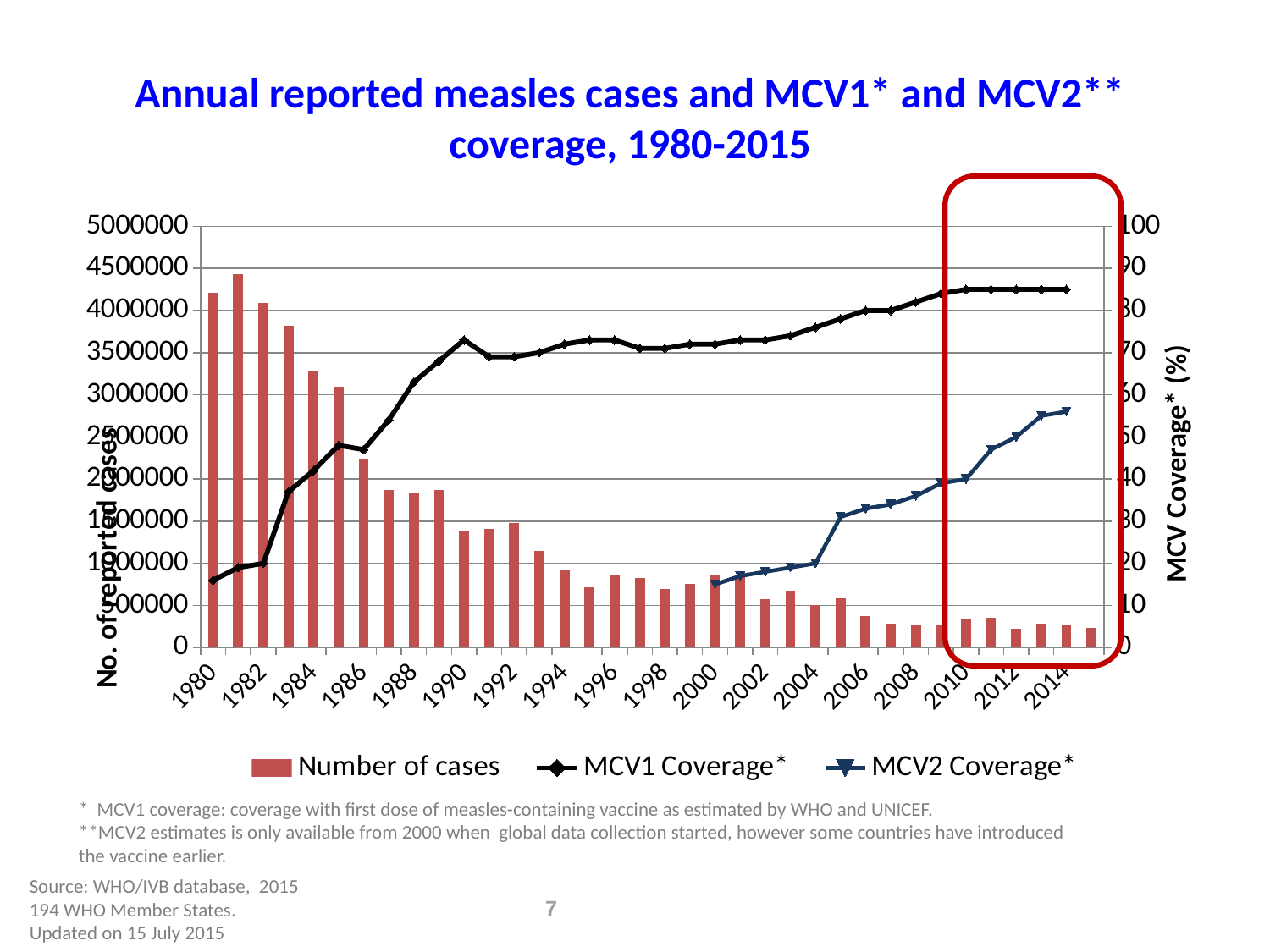
Which year has the highest number of reported measles cases? 1981 In 2010, which is higher, MCV1 coverage or MCV2 coverage? MCV1 coverage Which is larger, the number of reported cases in 1981 or in 1983? 1981 Is the MCV1 coverage in 2014 greater or less than 80? greater Is the number of reported cases in 1981 greater or less than 4000000? greater Is the MCV2 coverage in 2000 greater or less than 20? less What kind of chart is shown on the slide? A combined bar and line chart How many series does the legend list? 3 Does the MCV1 coverage line generally rise or fall from 1980 to 2014? rise Which series is plotted as bars according to the legend? Number of cases